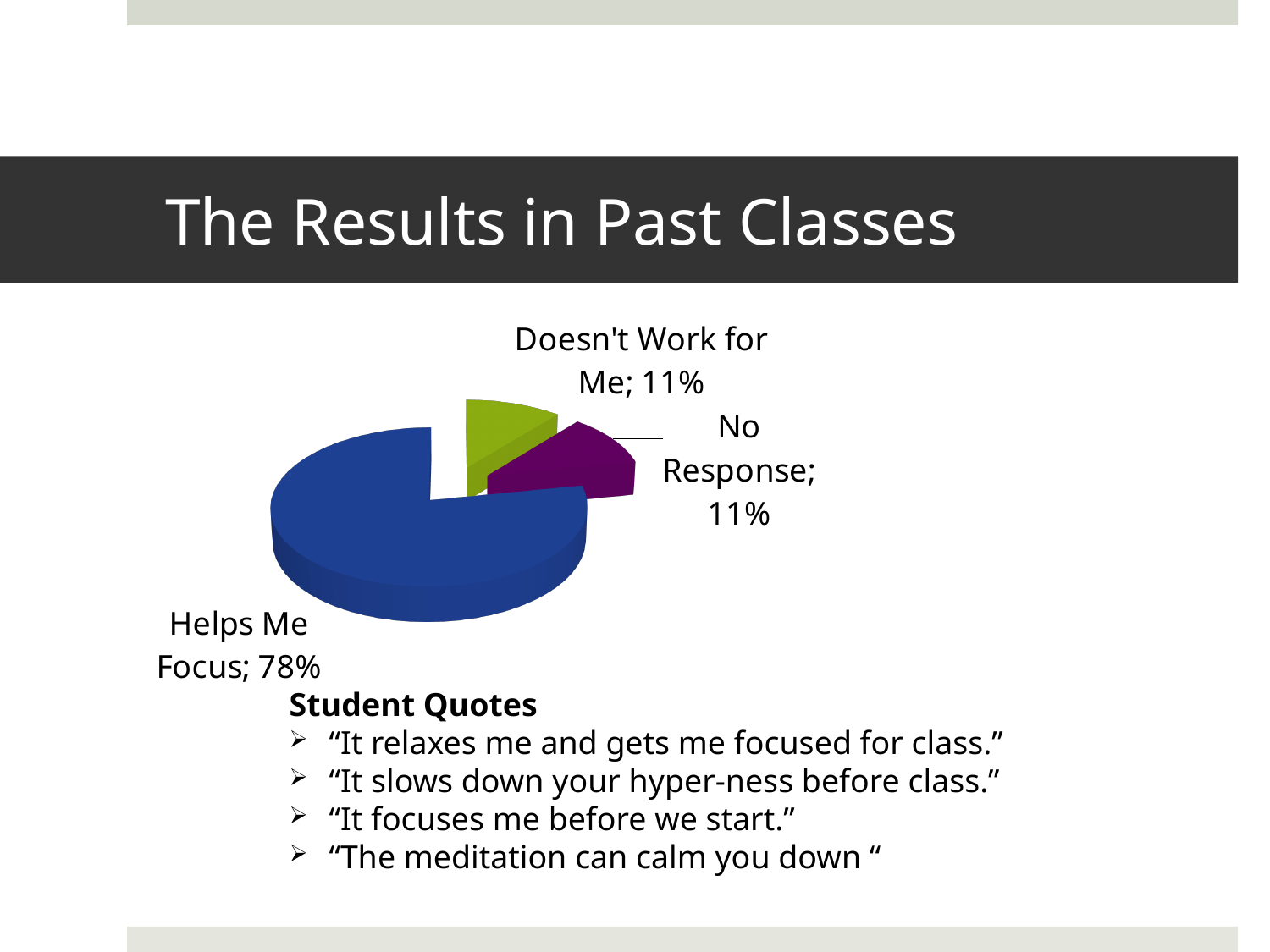
What kind of chart is shown on the slide? Pie chart Which slice of the pie is the largest? Helps Me Focus Is the share for "Helps Me Focus" greater or less than 50%? greater How many slices does the pie chart have? 3 What share of the pie is labelled "Doesn't Work for Me"? 11% What colour is the "Helps Me Focus" slice? Blue What colour is the "No Response" slice? Purple What is the difference in percentage points between "Helps Me Focus" and "No Response"? 67 What share of the pie is labelled "No Response"? 11% What share of the pie is labelled "Helps Me Focus"? 78% Which is larger: the "Helps Me Focus" slice or the "Doesn't Work for Me" slice? Helps Me Focus